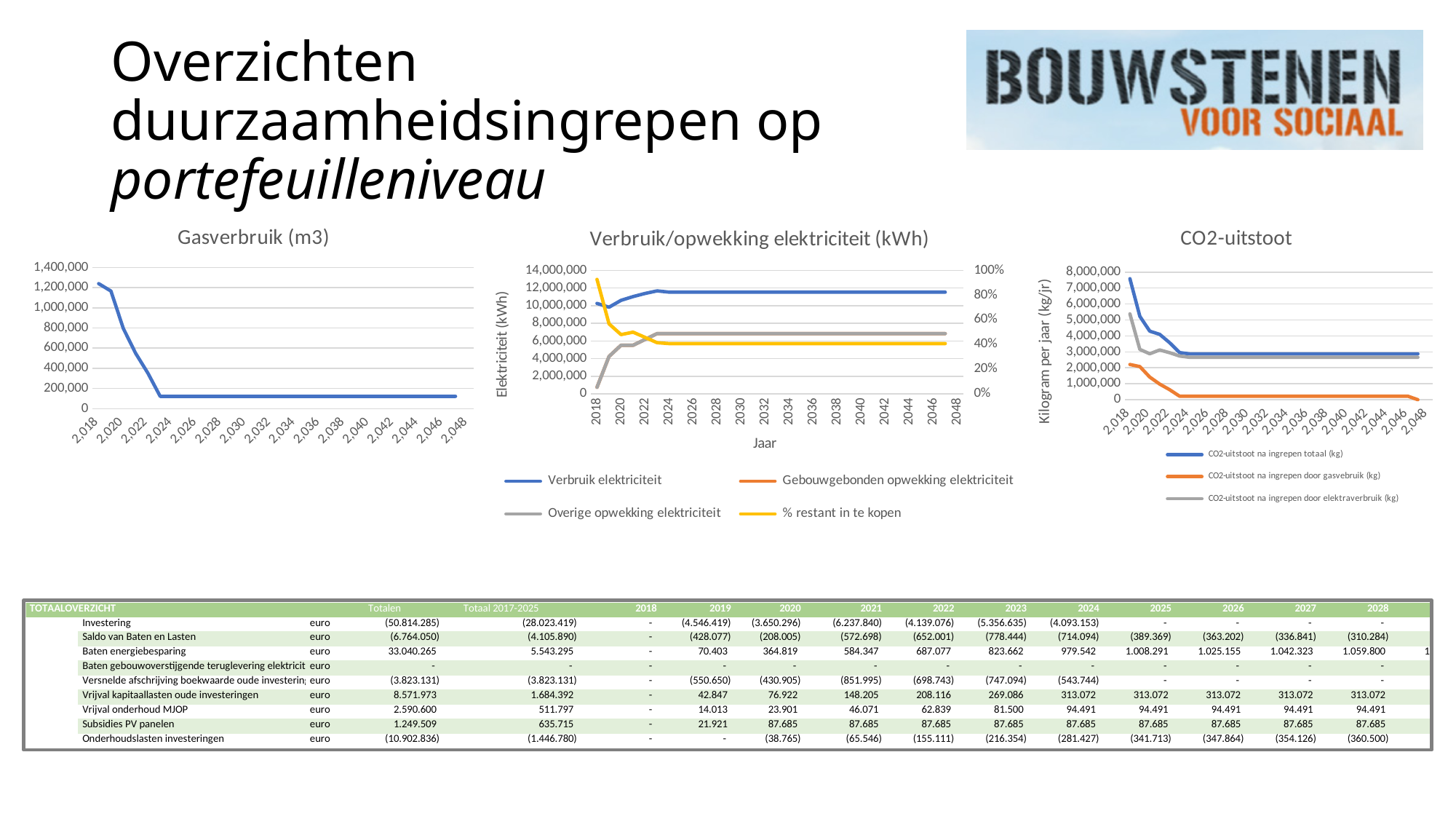
How many series does the legend of the 'Verbruik/opwekking elektriciteit (kWh)' chart list? 4 How many series does the legend of the 'CO2-uitstoot' chart list? 3 In the 'Verbruik/opwekking elektriciteit (kWh)' chart, is the value for 'Verbruik elektriciteit' in 2030 greater or less than 10,000,000? greater What is the x-axis title of the 'Verbruik/opwekking elektriciteit (kWh)' chart? Jaar In the 'CO2-uitstoot' chart, is the value for 'CO2-uitstoot na ingrepen totaal (kg)' in 2018 greater or less than 6,000,000? greater In the 'Verbruik/opwekking elektriciteit (kWh)' chart, which is larger in 2018: 'Verbruik elektriciteit' or 'Overige opwekking elektriciteit'? Verbruik elektriciteit What kind of chart is the 'Gasverbruik (m3)' chart? line chart In the 'Gasverbruik (m3)' chart, is the value for 2030 greater or less than 200,000? less In the 'Gasverbruik (m3)' chart, do the values rise or fall from 2018 to 2024? fall What is the y-axis title of the 'CO2-uitstoot' chart? Kilogram per jaar (kg/jr) In the 'Gasverbruik (m3)' chart, which year has the highest value? 2018